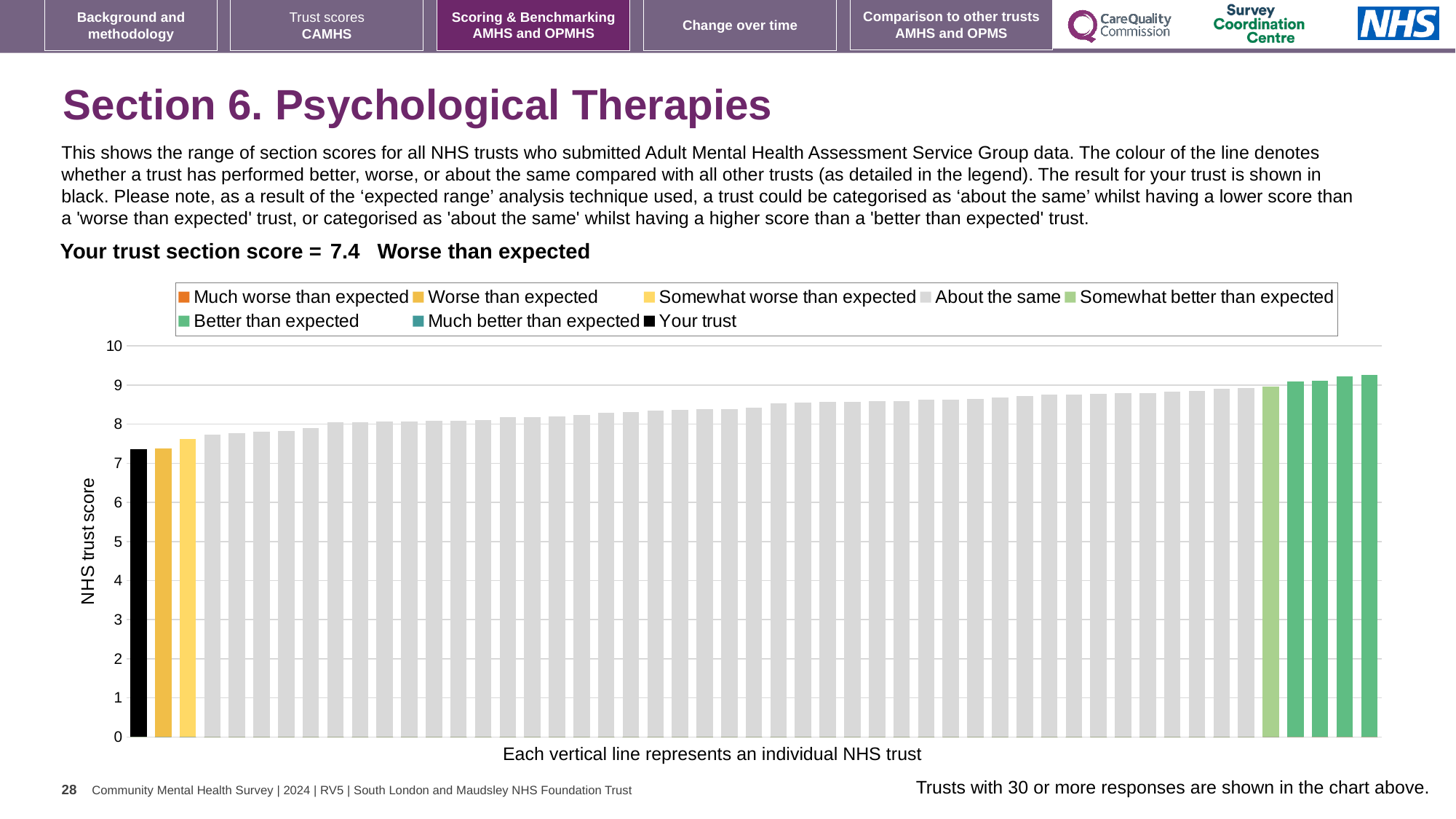
What kind of chart is shown on the slide? bar chart What is the maximum value shown on the vertical axis? 10 Is the value for your trust greater or less than 8? less What colour is the bar representing your trust? black How many entries does the chart legend list? 8 Do the bar values rise or fall from left to right along the x axis? rise Which legend category do the tallest bars on the right of the chart belong to? Better than expected Which performance category is your trust placed in for this section? Worse than expected Is the value of the shortest bar in the chart greater or less than 7? greater What is the section score for your trust shown on the slide? 7.4 Is the value of the tallest bar in the chart greater or less than 9? greater What is the label on the vertical axis of the chart? NHS trust score